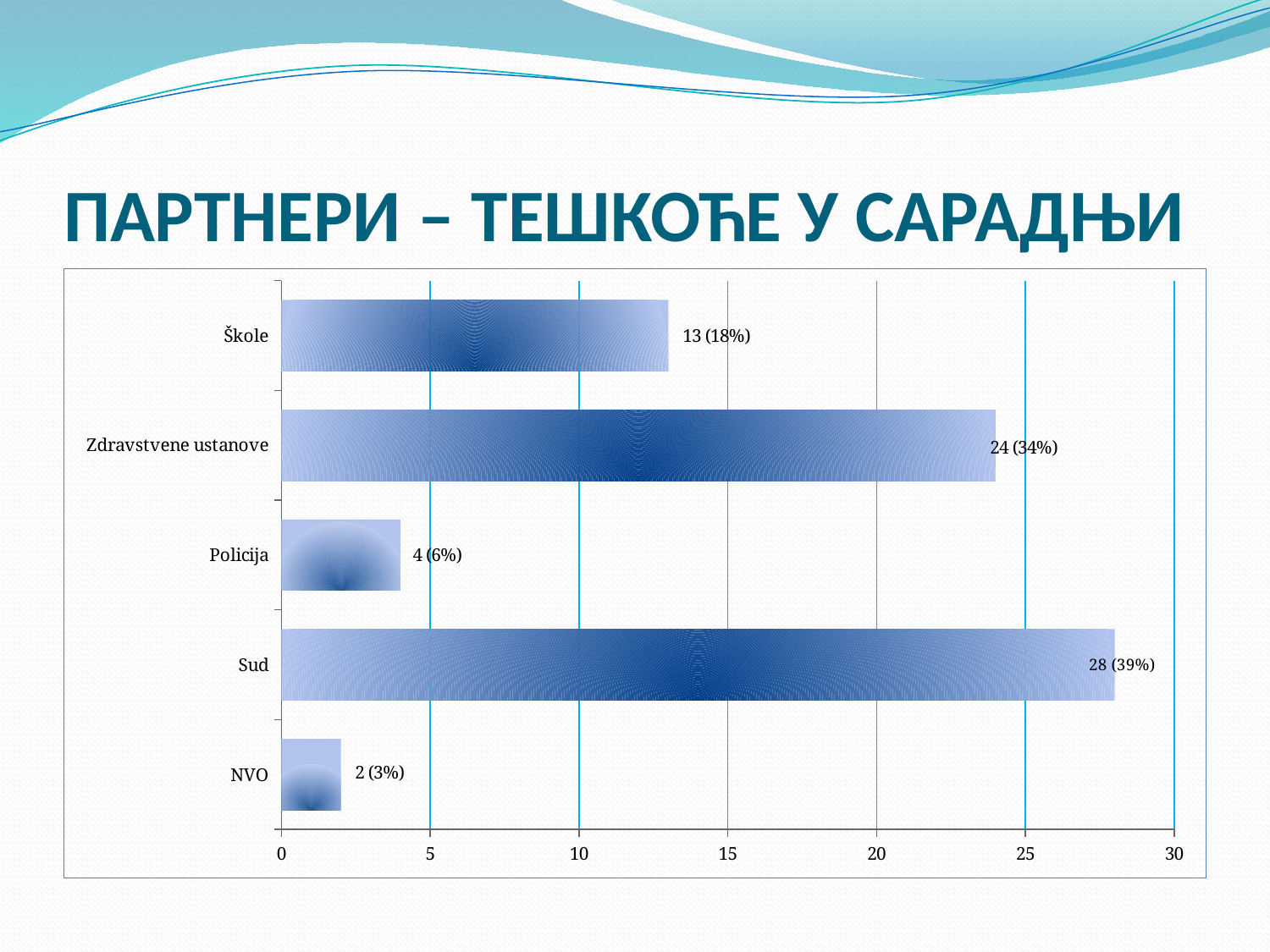
What is the difference between the count for Sud and the count for Zdravstvene ustanove? 4 What is the data label shown for NVO? 2 (3%) What kind of chart is shown on the slide? bar chart Which category has the lowest value? NVO What is the data label shown for Zdravstvene ustanove? 24 (34%) Is the value for Zdravstvene ustanove greater or less than 20? greater Which category has the highest value? Sud What is the maximum value shown on the horizontal axis? 30 How many categories are shown on the chart? 5 What is the data label shown for Policija? 4 (6%) What is the data label shown for Sud? 28 (39%) Which has a larger value, Škole or Policija? Škole